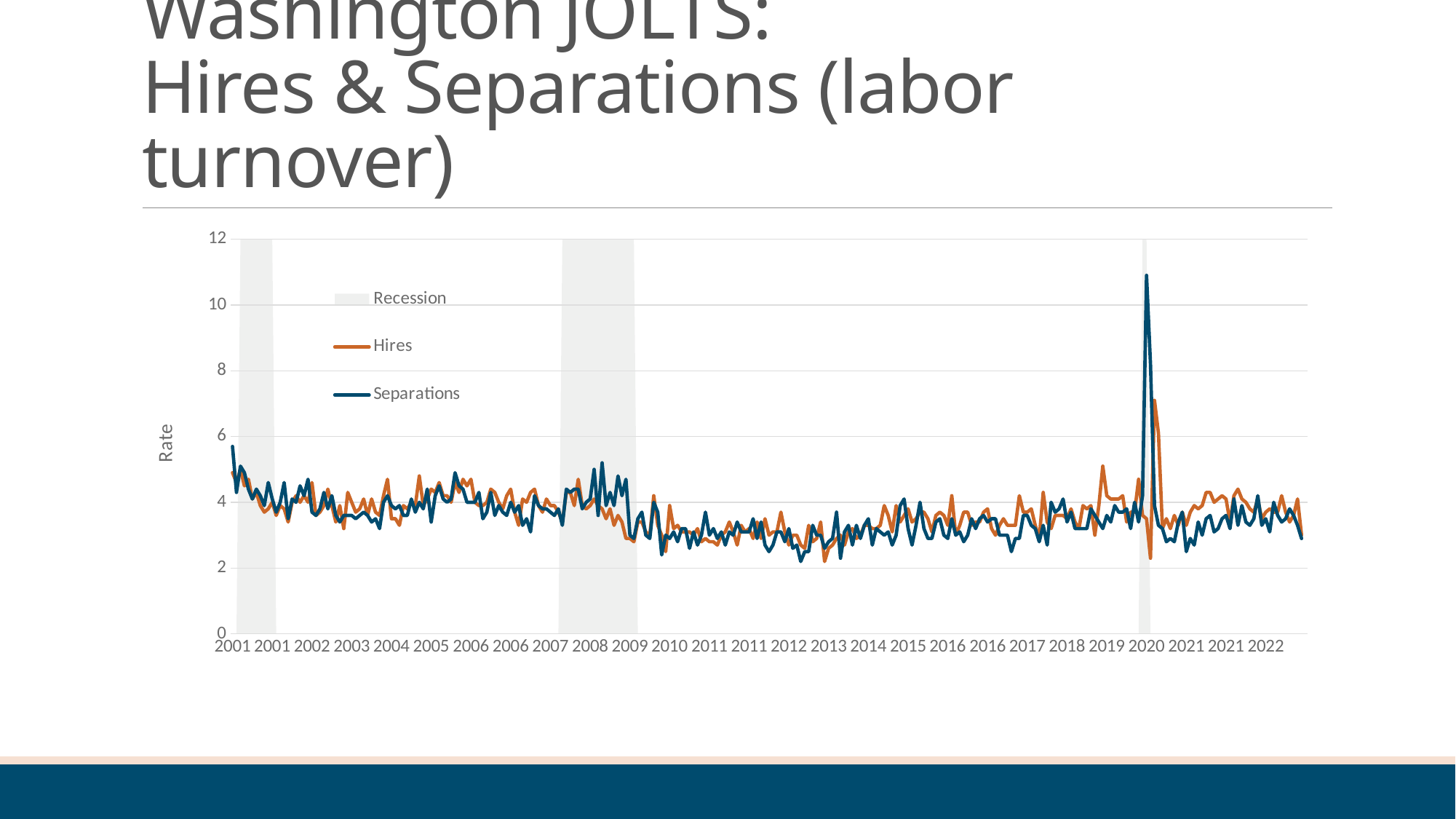
How many entries does the chart legend list? 3 What kind of chart is shown on the slide? line chart Is the Hires value at the start of 2013 greater or less than 4? less What is the label on the vertical axis? Rate How many shaded recession periods are shown on the chart? 3 Do the Hires values generally rise or fall from 2001 to 2013? fall Is the first Separations value in 2001 greater or less than 4? greater Is the peak value of Separations in 2020 greater or less than 10? greater Which series reaches the highest peak in 2020, Hires or Separations? Separations What is the highest value shown on the vertical axis? 12